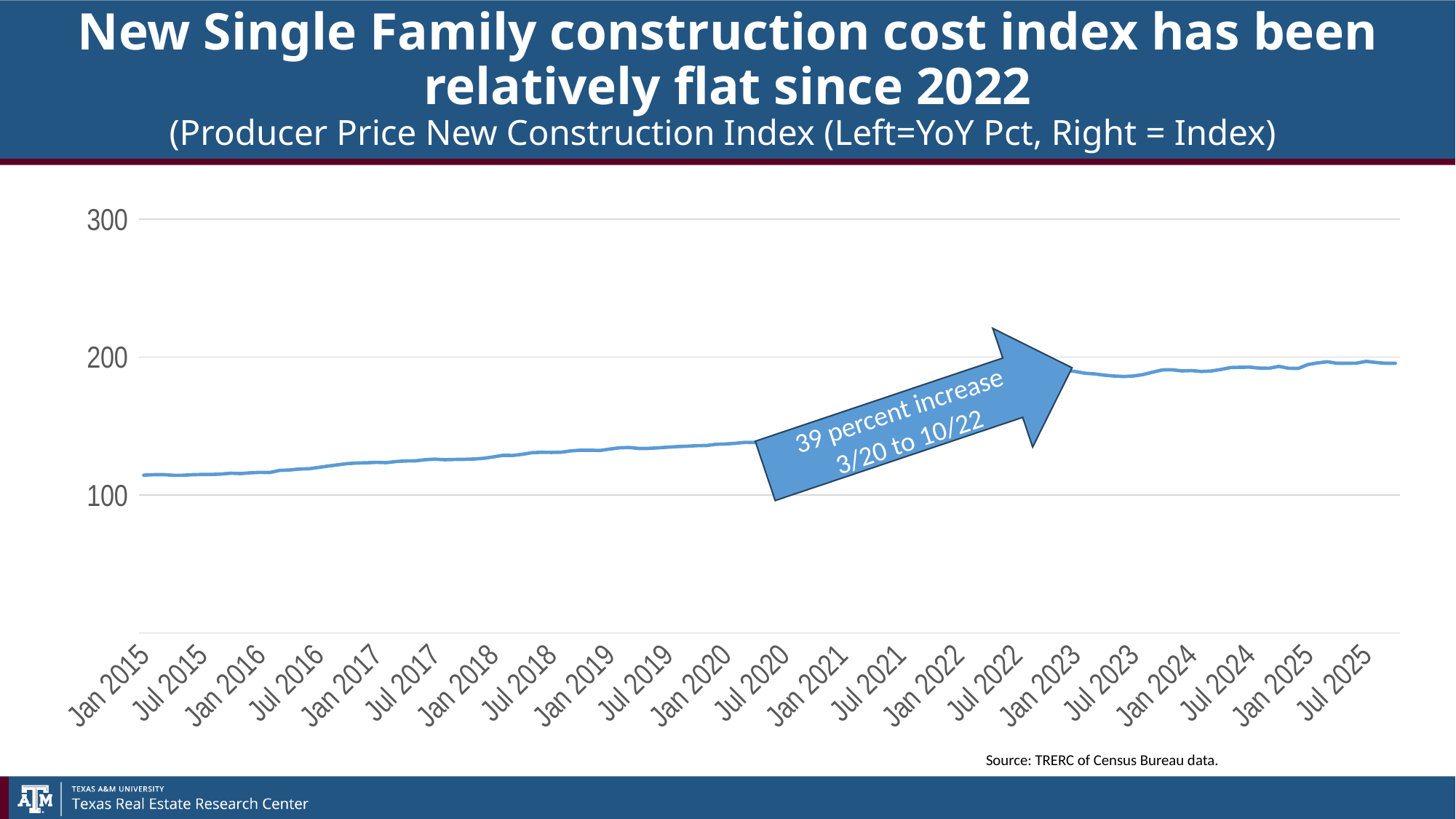
What is the highest value shown on the y axis? 300 Is the index value at Jan 2020 greater or less than 200? less Does the construction cost index generally rise or fall from Jan 2015 to Jul 2025? Rise Is the index value at Jan 2015 greater or less than 200? less Which is larger, the index value at Jan 2015 or at Jul 2025? Jul 2025 Is the index value at Jan 2024 greater or less than 100? greater What kind of chart is shown on the slide? Line chart Which is larger, the index value at Jan 2018 or at Jan 2023? Jan 2023 What percent increase does the arrow annotation say occurred from 3/20 to 10/22? 39 percent How many date labels are shown on the x axis? 22